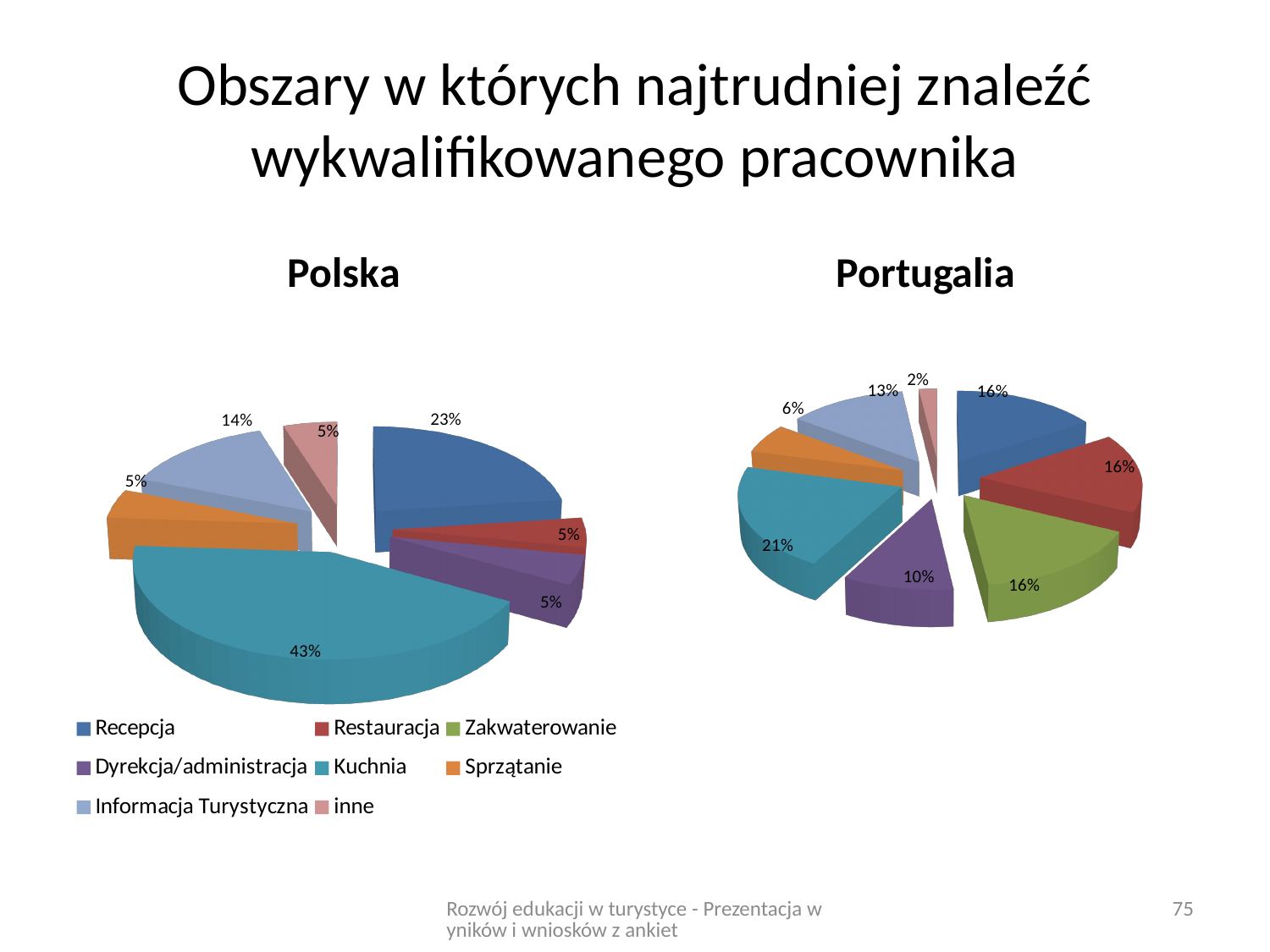
In the Polska chart, what is the difference between the shares of Kuchnia and Recepcja? 20 percentage points In the Polska chart, what share does Recepcja have? 23% In the Portugalia chart, what share does inne have? 2% In the Portugalia chart, what share does Kuchnia have? 21% In the Polska chart, what share does Kuchnia have? 43% In the Polska chart, which category has the largest share? Kuchnia How many categories does the legend list? 8 In the Portugalia chart, which category has the smallest share? inne In the Portugalia chart, which is larger: the share of Kuchnia or the share of Sprzątanie? Kuchnia What type of chart is used for Polska and Portugalia? Pie chart In the Polska chart, what share does Informacja Turystyczna have? 14% In the Portugalia chart, what share does Dyrekcja/administracja have? 10%